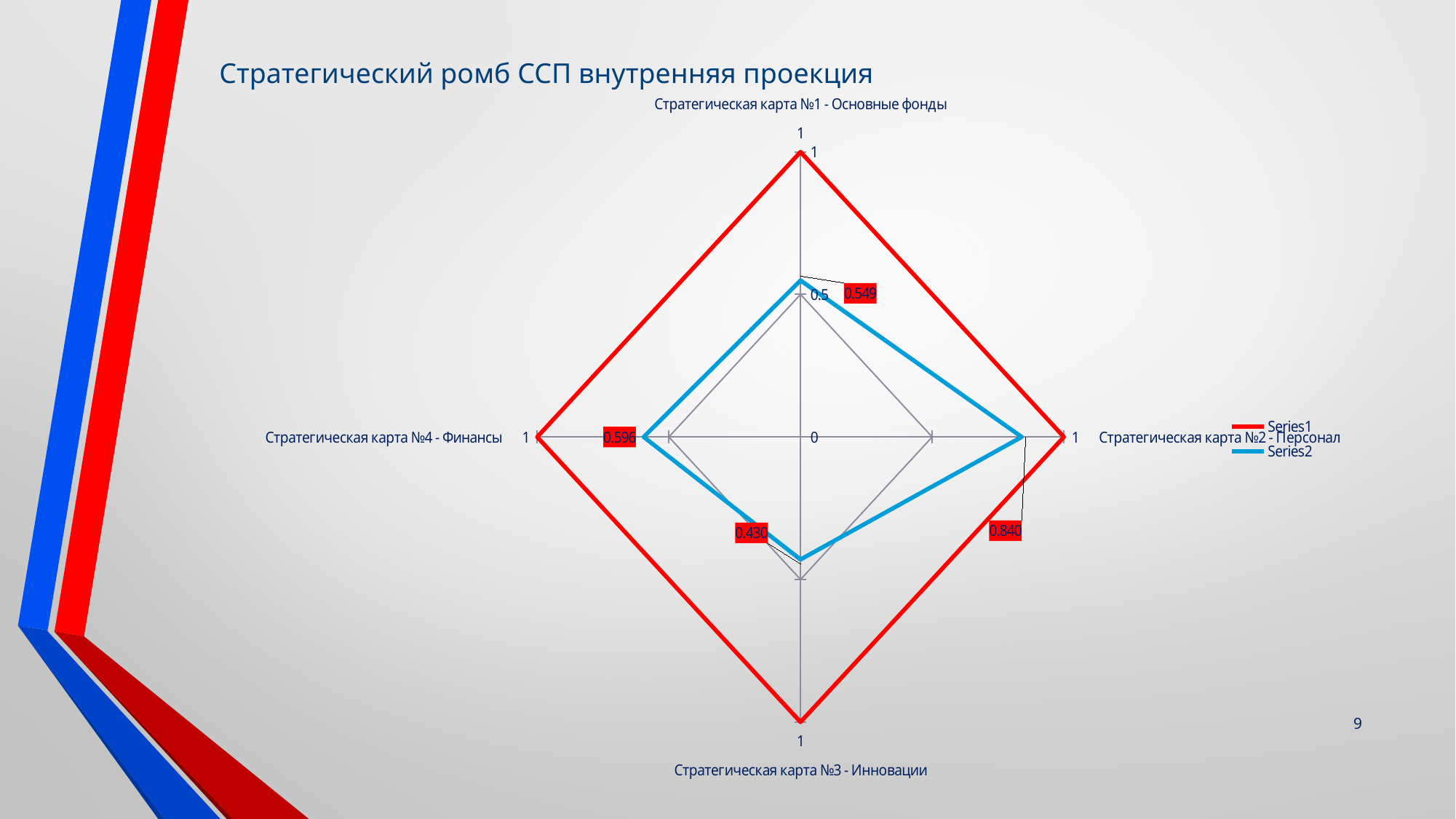
How many categories (axes) does the radar chart have? 4 What is the Series2 value for Стратегическая карта №4 - Финансы? 0.596 What is the Series2 value for Стратегическая карта №3 - Инновации? 0.430 How many series does the legend list? 2 What kind of chart is shown on the slide? radar chart What is the difference between the Series2 values for Стратегическая карта №2 - Персонал and Стратегическая карта №3 - Инновации? 0.410 Which category has the highest Series2 value? Стратегическая карта №2 - Персонал Is the Series2 value for Стратегическая карта №4 - Финансы greater or less than 0.5? greater Which colour is used for Series1 in the chart? red Which category has the lowest Series2 value? Стратегическая карта №3 - Инновации What is the Series2 value for Стратегическая карта №1 - Основные фонды? 0.549 What is the Series2 value for Стратегическая карта №2 - Персонал? 0.840